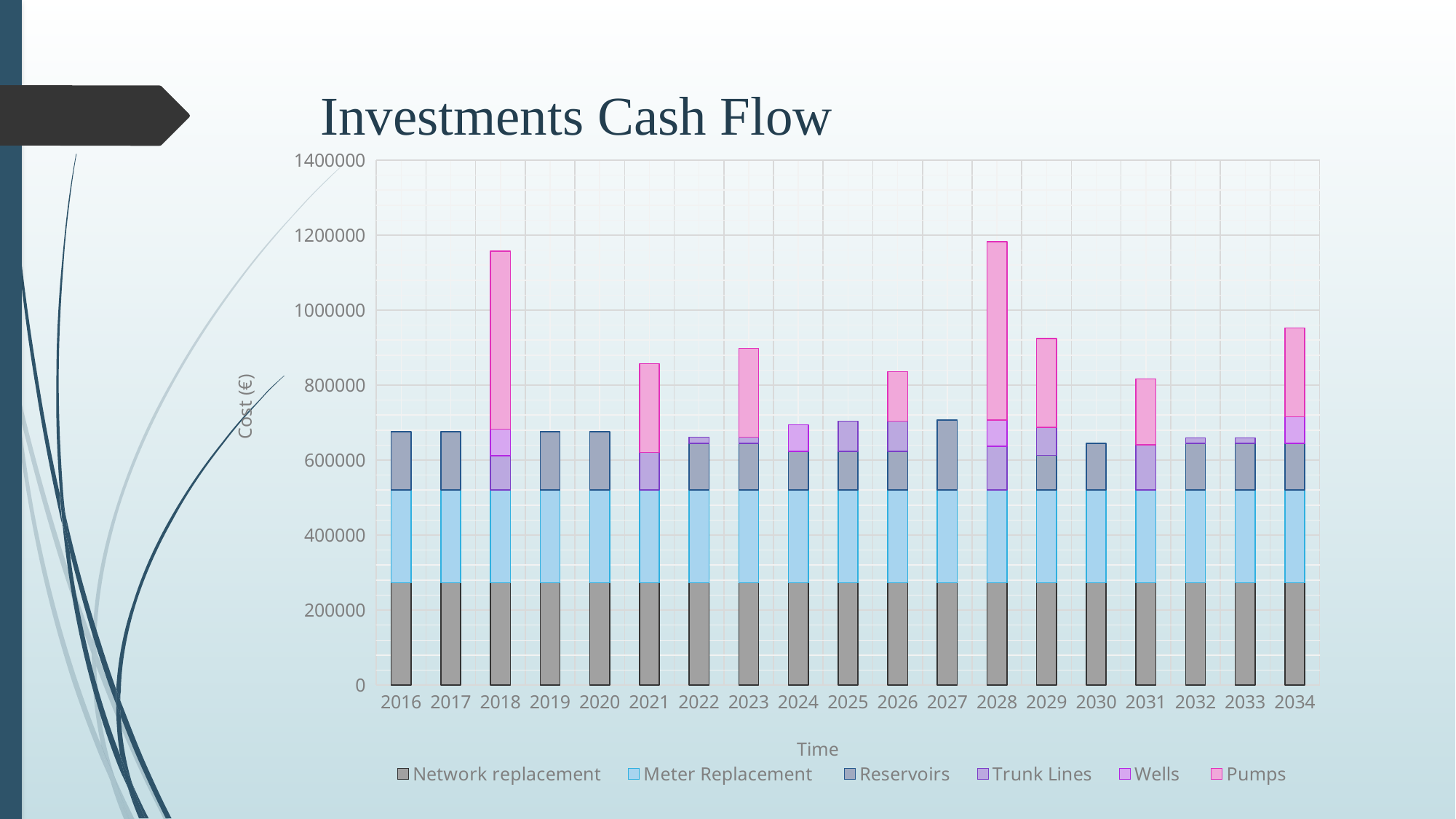
Which year has the larger total, 2023 or 2024? 2023 Which year has the highest total investment cost? 2028 What is the label of the vertical axis? Cost (€) How many series does the legend list? 6 Is the total value for 2018 greater or less than 1000000? greater Is the total value for 2034 greater or less than 800000? greater Is the total value for 2030 greater or less than 800000? less How many years are shown on the x axis of the chart? 19 What kind of chart is shown on the slide? Stacked bar chart What is the title of the chart? Investments Cash Flow Which year has the larger total, 2018 or 2019? 2018